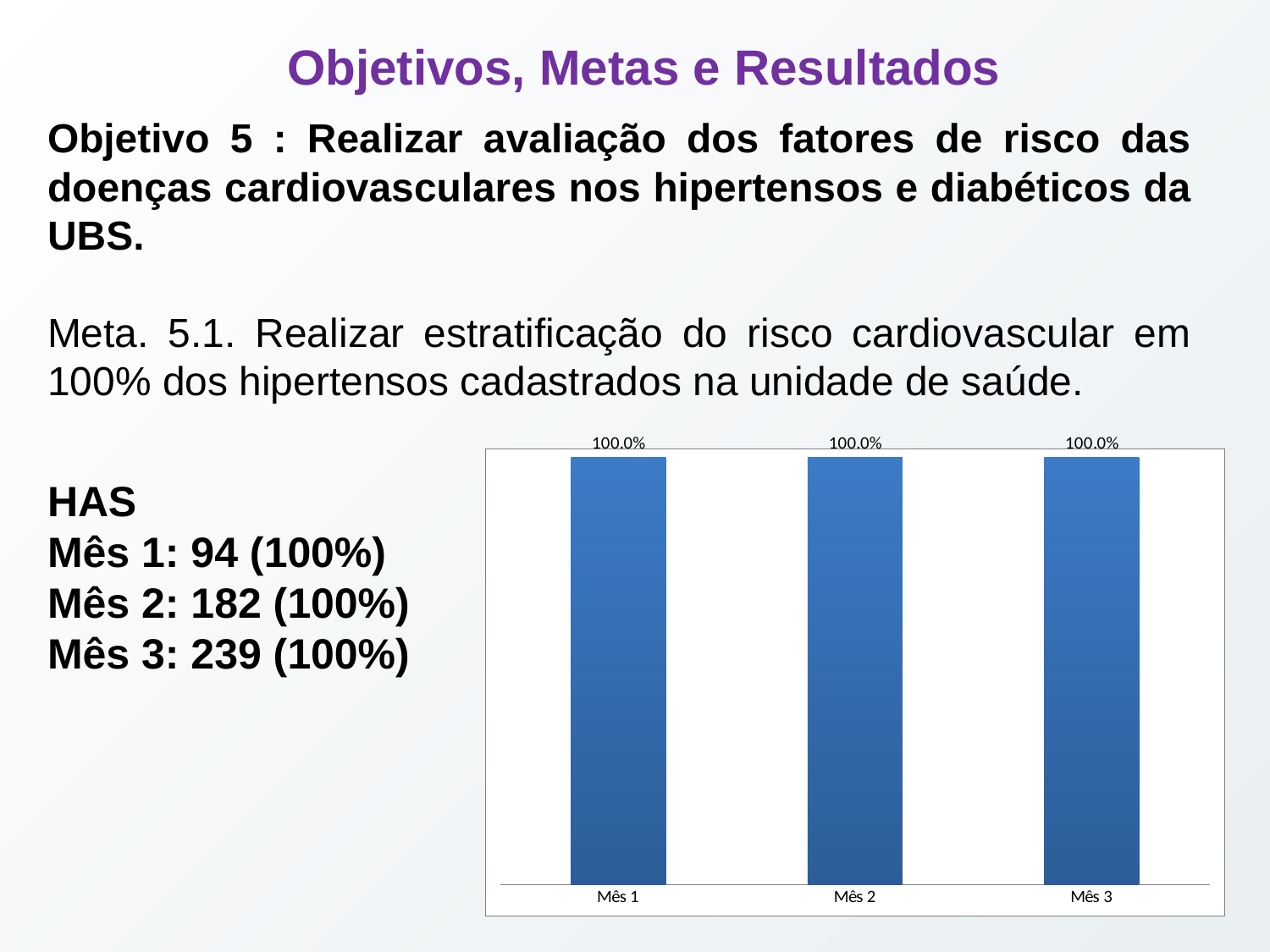
How many bars (categories) does the chart show? 3 What colour are the bars in the chart? blue What kind of chart is shown on the slide? bar chart What is the label of the first category on the x axis of the chart? Mês 1 What is the value shown for Mês 3 in the chart? 100.0% What is the difference between the values for Mês 3 and Mês 1 in the chart? 0.0% What is the value shown for Mês 2 in the chart? 100.0% What is the value shown for Mês 1 in the chart? 100.0% Do the values in the chart rise, fall, or stay the same from Mês 1 to Mês 3? stay the same